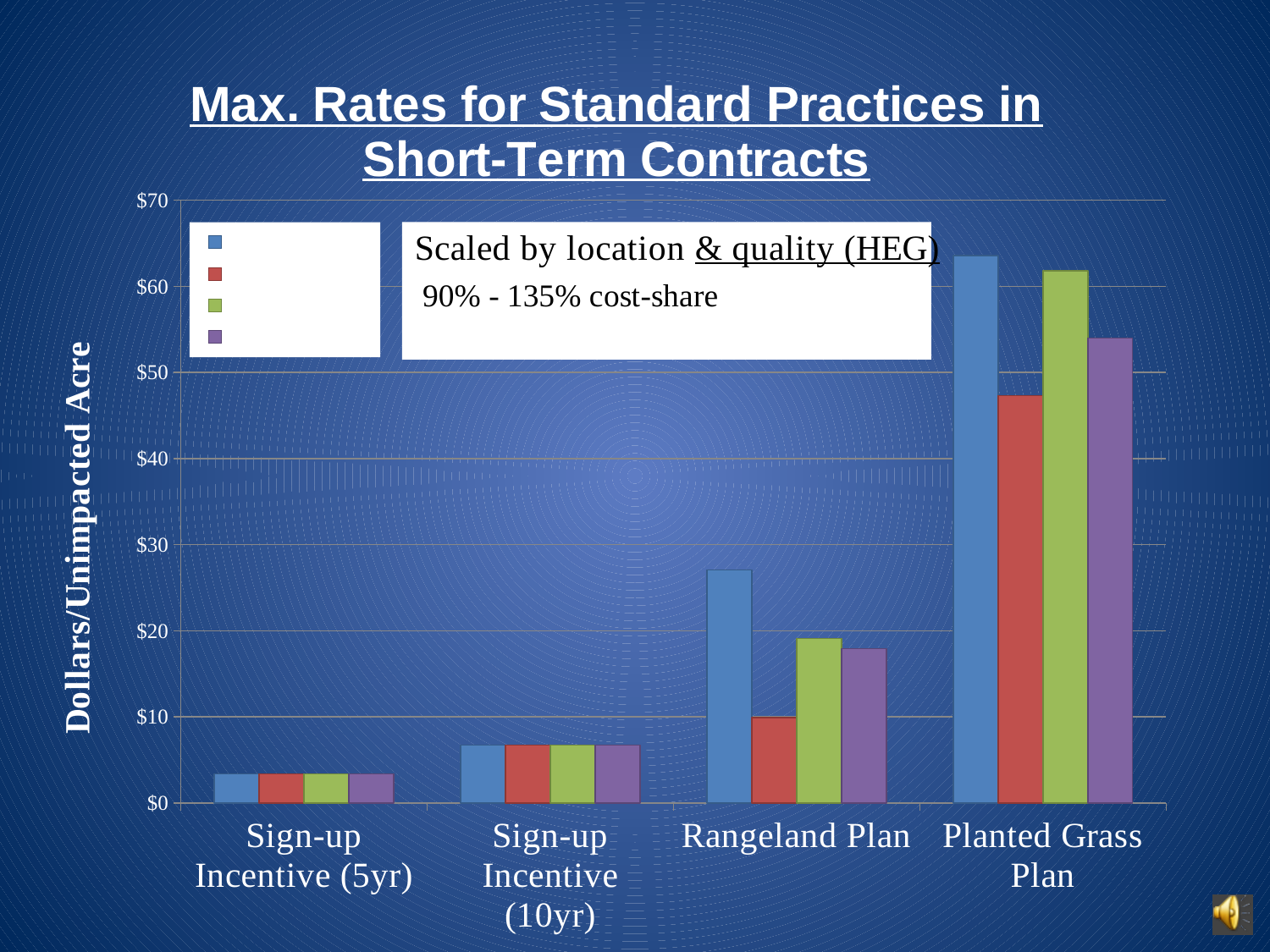
Is the value of the red bar for Planted Grass Plan greater or less than $50? less Which category has the highest bars in the chart? Planted Grass Plan What kind of chart is shown on the slide? Bar chart What is the label on the chart's vertical axis? Dollars/Unimpacted Acre Which category has the lowest bars in the chart? Sign-up Incentive (5yr) Is the value of the blue bar for Planted Grass Plan greater or less than $60? greater How many series does the chart's legend list? 4 Do the bar heights generally rise or fall moving from left to right across the categories? rise Are the bars for Sign-up Incentive (10yr) greater or less than $10? less Is the blue bar for Rangeland Plan larger or smaller than the blue bar for Planted Grass Plan? smaller How many categories are shown along the x axis of the chart? 4